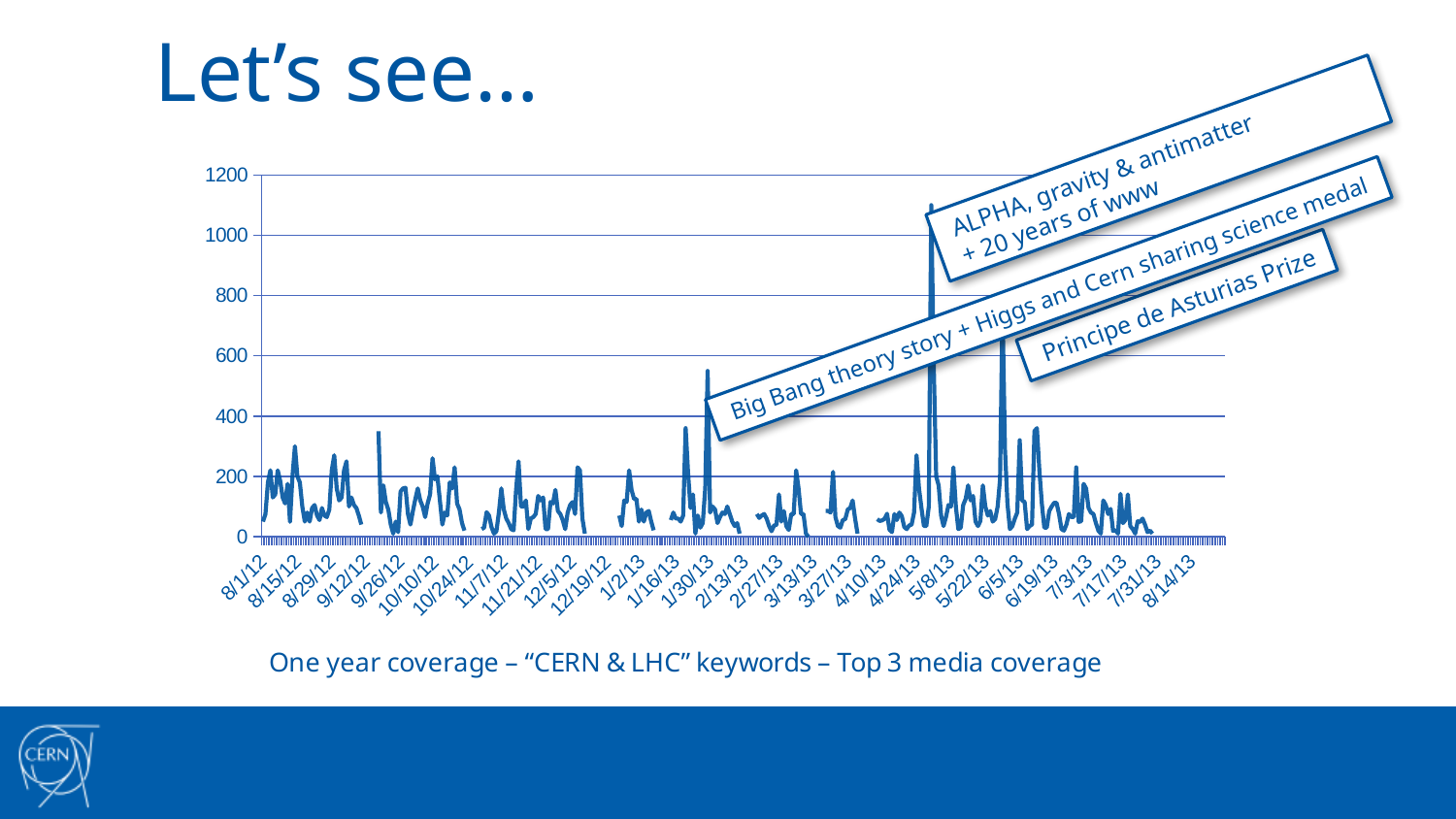
Near which x-axis date label does the highest spike in the chart occur? 5/8/13 Is the value of the spike near 6/5/13 greater or less than 600? greater Which spike is taller: the one near 1/30/13 or the one near 5/8/13? the one near 5/8/13 What is the first date label on the x axis of the chart? 8/1/12 Which spike is taller: the one near 9/26/12 or the one near 6/5/13? the one near 6/5/13 Is the value of the spike near 9/26/12 greater or less than 400? less What is the highest value shown on the y axis of the chart? 1200 Is the value of the spike near 1/30/13 greater or less than 400? greater What kind of chart is shown on the slide? line chart